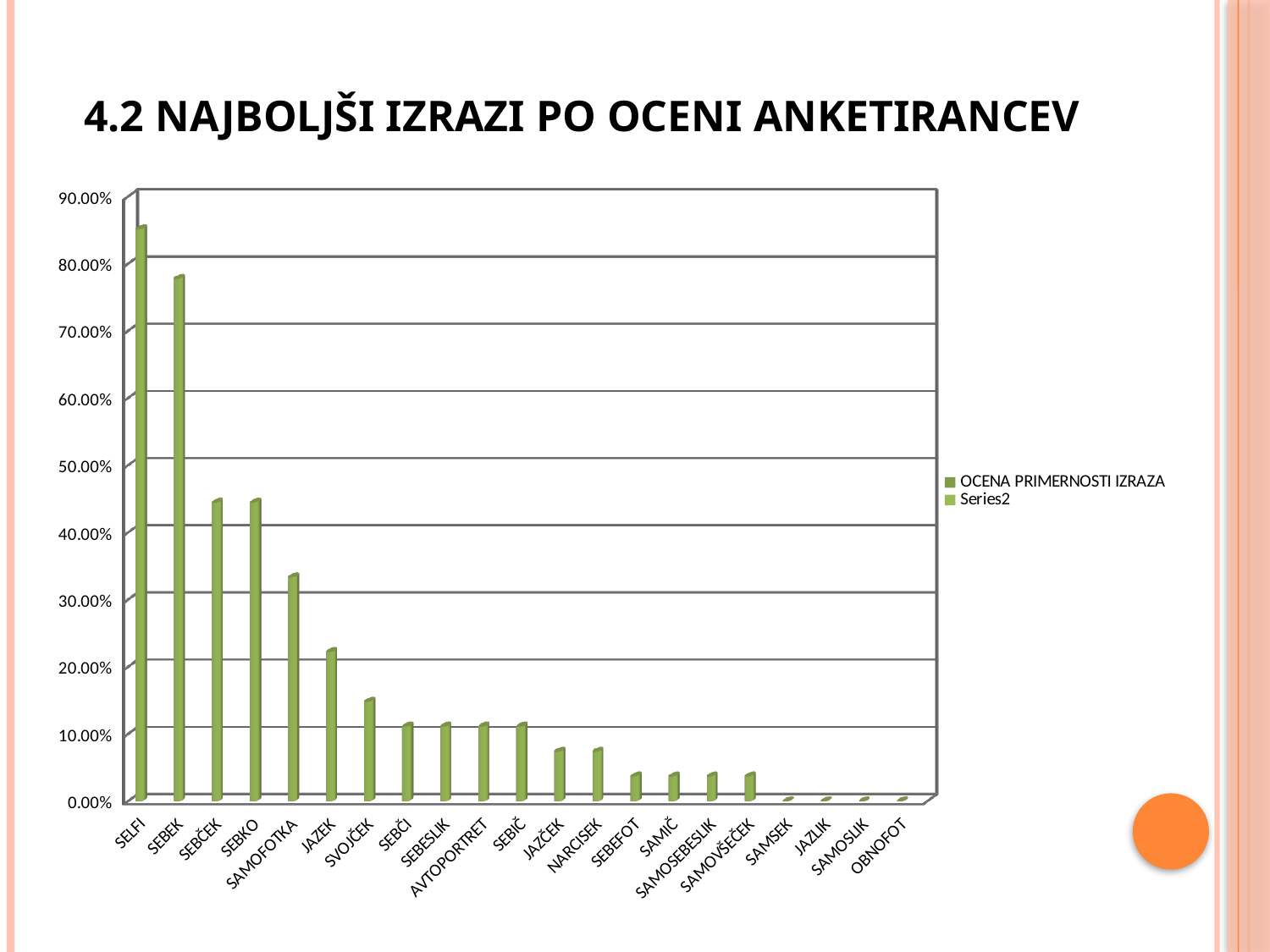
Which is larger, the value for SAMOFOTKA or the value for JAZEK? SAMOFOTKA Is the value for SELFI greater or less than 80.00%? greater Which category has the highest value in the chart? SELFI What kind of chart is shown on the slide? bar chart Is the value for SAMOFOTKA greater or less than 30.00%? greater Is the value for SEBEK greater or less than 70.00%? greater How many categories are shown on the x axis of the chart? 21 Do the values generally rise or fall from left to right along the x axis? fall Which is larger, the value for SELFI or the value for SEBEK? SELFI How many series does the legend list? 2